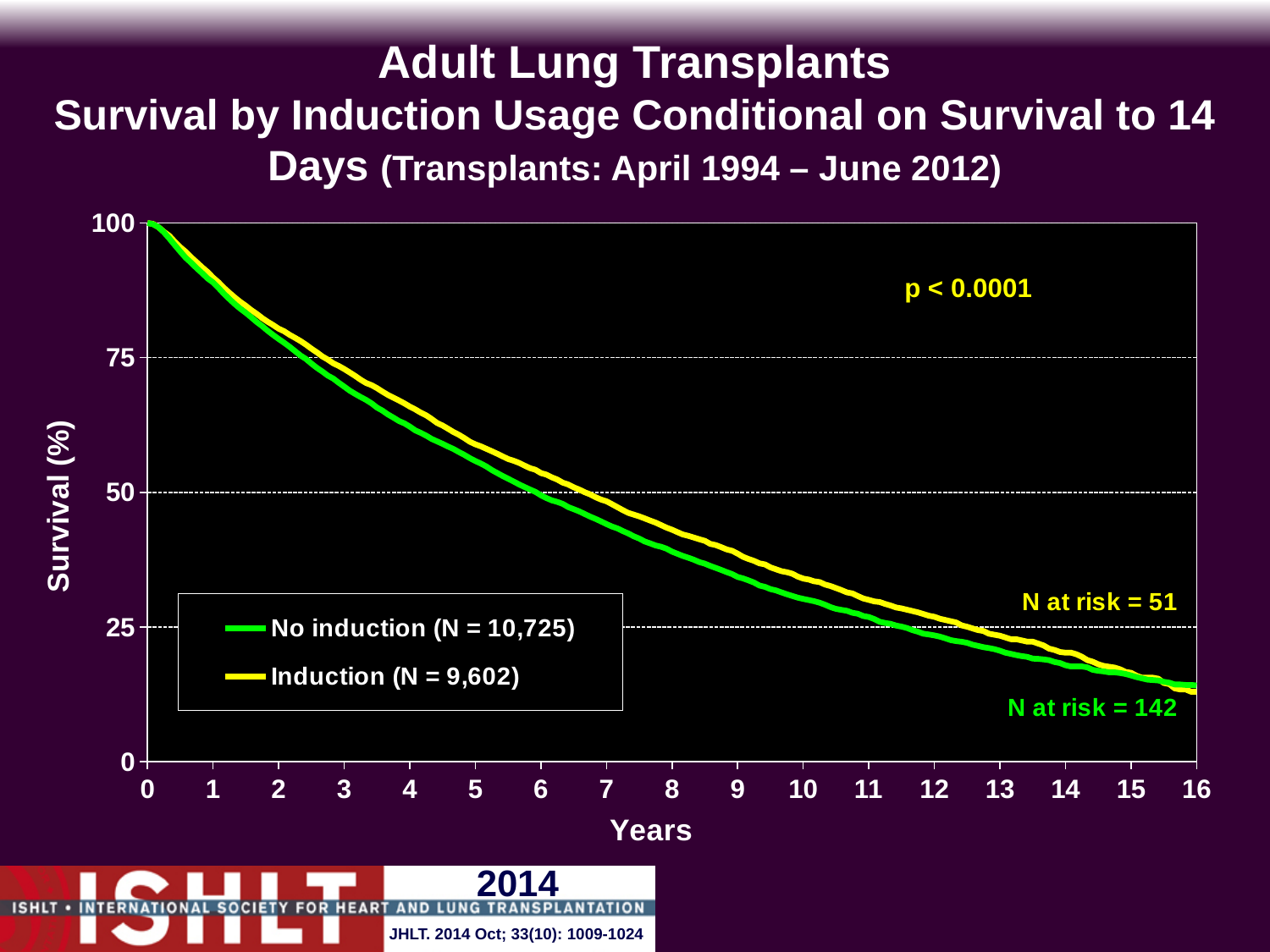
What is the label of the y axis? Survival (%) What is the N for the Induction group shown in the legend? 9,602 How many series does the legend list? 2 What is the N at risk printed next to the Induction (yellow) curve at the end of follow-up? 51 Is the survival value for the No induction group at 8 years greater or less than 50? less What kind of chart is shown on the slide? line chart Is the survival value for the Induction group at 1 year greater or less than 75? greater What is the N for the No induction group shown in the legend? 10,725 At 6 years, which curve shows higher survival, Induction or No induction? Induction Do the survival curves rise or fall as years increase along the x axis? fall What p-value is printed on the chart? p < 0.0001 What is the N at risk printed next to the No induction (green) curve at the end of follow-up? 142